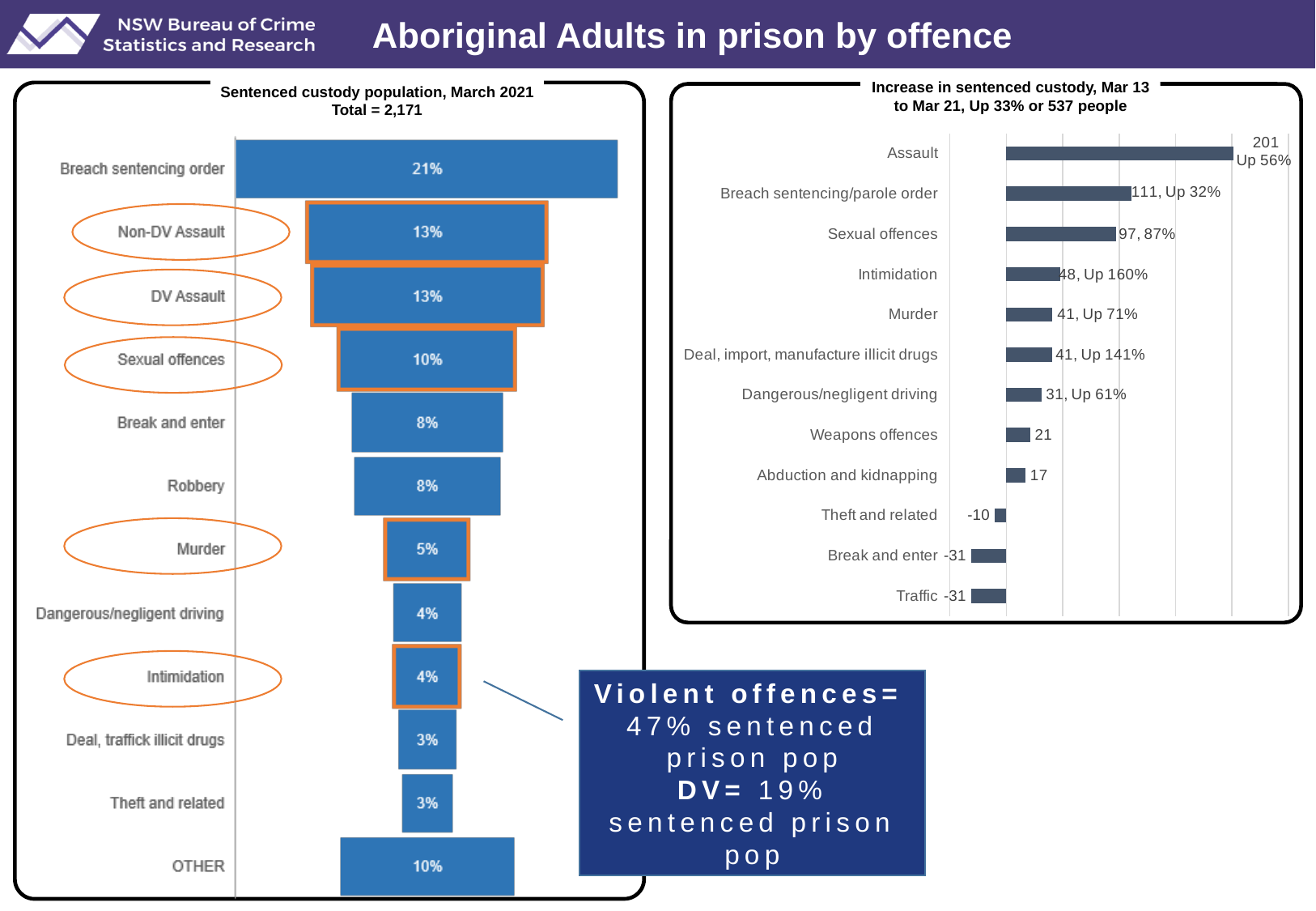
In the 'Sentenced custody population, March 2021' chart, what total is stated in the title? 2,171 In the 'Increase in sentenced custody, Mar 13 to Mar 21' chart, what value is shown for Theft and related? -10 In the 'Increase in sentenced custody, Mar 13 to Mar 21' chart, what percentage increase is shown for Intimidation? Up 160% In the 'Sentenced custody population, March 2021' chart, which offence category has the highest percentage? Breach sentencing order What type of chart is the 'Increase in sentenced custody, Mar 13 to Mar 21' chart? Bar chart In the 'Sentenced custody population, March 2021' chart, what percentage is shown for Sexual offences? 10% In the 'Increase in sentenced custody, Mar 13 to Mar 21' chart, what is the increase shown for Assault? 201 In the 'Increase in sentenced custody, Mar 13 to Mar 21' chart, which offence category has the largest increase? Assault In the 'Sentenced custody population, March 2021' chart, what is the difference in percentage points between Breach sentencing order and Murder? 16 In the 'Sentenced custody population, March 2021' chart, what percentage is shown for Breach sentencing order? 21% In the 'Sentenced custody population, March 2021' chart, how many offence categories are shown? 12 In the 'Increase in sentenced custody, Mar 13 to Mar 21' chart, which is larger: the increase for Breach sentencing/parole order or for Sexual offences? Breach sentencing/parole order